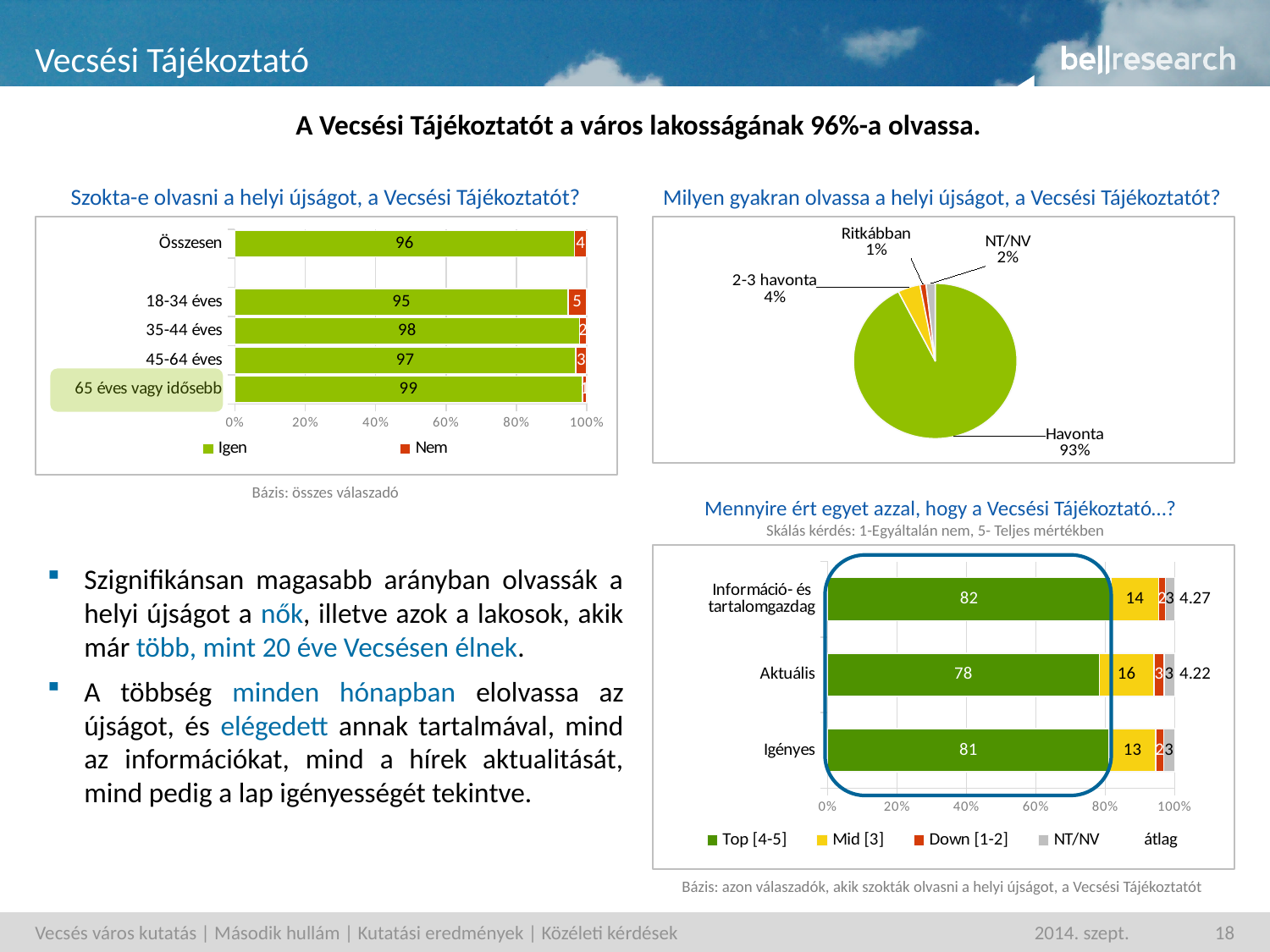
In the chart 'Szokta-e olvasni a helyi újságot, a Vecsési Tájékoztatót?', what is the 'Igen' value for 'Összesen'? 96 In the chart 'Mennyire ért egyet azzal, hogy a Vecsési Tájékoztató…?', what is the 'átlag' value for 'Információ- és tartalomgazdag'? 4.27 In the chart 'Mennyire ért egyet azzal, hogy a Vecsési Tájékoztató…?', which category has the highest 'Mid [3]' value? Aktuális In the chart 'Szokta-e olvasni a helyi újságot, a Vecsési Tájékoztatót?', what is the 'Nem' value for '18-34 éves'? 5 What type of chart is 'Mennyire ért egyet azzal, hogy a Vecsési Tájékoztató…?'? Stacked bar chart How many slices does the pie chart 'Milyen gyakran olvassa a helyi újságot, a Vecsési Tájékoztatót?' have? 4 In the pie chart 'Milyen gyakran olvassa a helyi újságot, a Vecsési Tájékoztatót?', what share does 'Havonta' have? 93% In the chart 'Szokta-e olvasni a helyi újságot, a Vecsési Tájékoztatót?', which age group has the highest 'Igen' value? 65 éves vagy idősebb In the pie chart 'Milyen gyakran olvassa a helyi újságot, a Vecsési Tájékoztatót?', which slice is the smallest? Ritkábban In the chart 'Mennyire ért egyet azzal, hogy a Vecsési Tájékoztató…?', what is the 'Top [4-5]' value for 'Aktuális'? 78 In the chart 'Szokta-e olvasni a helyi újságot, a Vecsési Tájékoztatót?', what is the difference between the 'Igen' values for '35-44 éves' and '18-34 éves'? 3 In the chart 'Szokta-e olvasni a helyi újságot, a Vecsési Tájékoztatót?', how many series does the legend list? 2